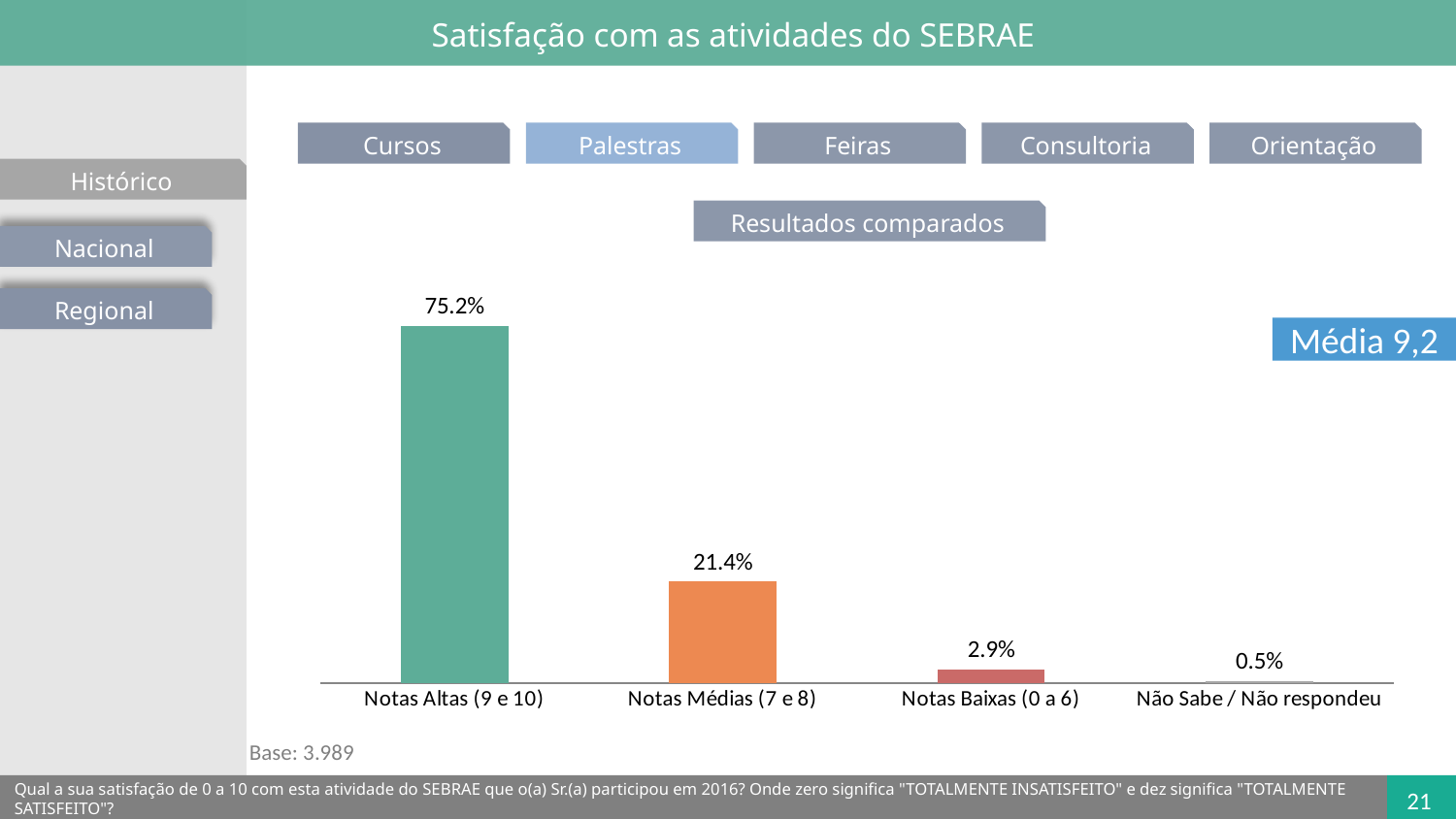
What is the value for Notas Baixas (0 a 6)? 2.9% What is the value for Não Sabe / Não respondeu? 0.5% Which is larger, the value for Notas Médias (7 e 8) or the value for Notas Baixas (0 a 6)? Notas Médias (7 e 8) How many categories are shown on the x axis of the chart? 4 Which category has the highest value? Notas Altas (9 e 10) What is the difference between the values for Notas Altas (9 e 10) and Notas Médias (7 e 8)? 53.8% What kind of chart is shown on the slide? Bar chart What is the value for Notas Médias (7 e 8)? 21.4% What is the difference between the values for Notas Baixas (0 a 6) and Não Sabe / Não respondeu? 2.4% Which category has the lowest value? Não Sabe / Não respondeu What average (Média) is shown in the box next to the chart? 9,2 What is the value for Notas Altas (9 e 10)? 75.2%